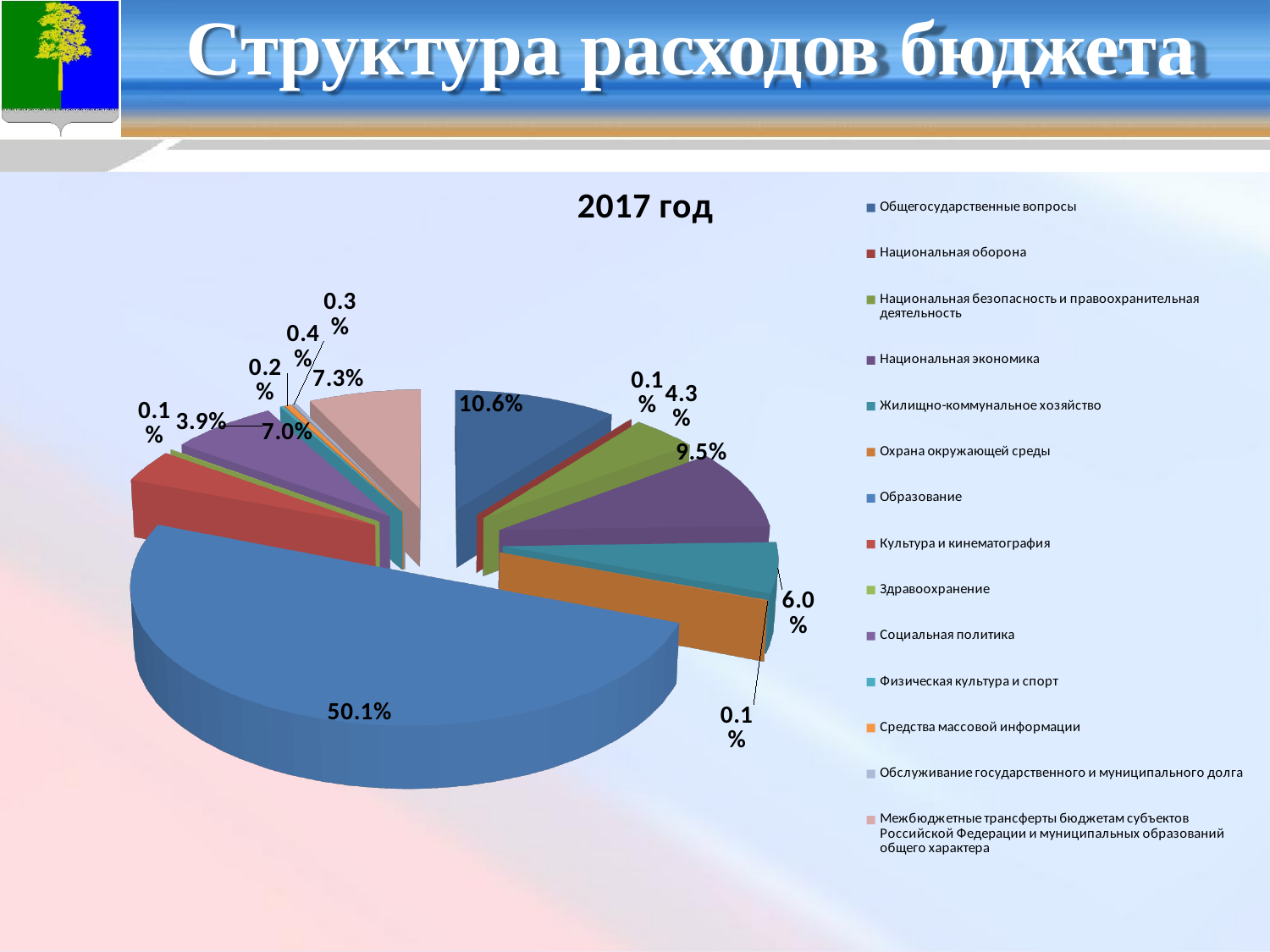
Is the share for Образование greater or less than half of the pie? greater What is the share for Национальная безопасность и правоохранительная деятельность? 4.3% Which category has the largest share of the pie? Образование By how many percentage points does the share for Общегосударственные вопросы exceed the share for Национальная экономика? 1.1 percentage points What is the share for Жилищно-коммунальное хозяйство? 6.0% What is the title of the chart? 2017 год What type of chart is shown on the slide? Pie chart What share of the budget expenditure goes to Образование? 50.1% Which is larger: the share for Общегосударственные вопросы or for Национальная экономика? Общегосударственные вопросы What is the share for Национальная экономика? 9.5% How many categories does the legend of the chart list? 14 What is the share for Общегосударственные вопросы? 10.6%